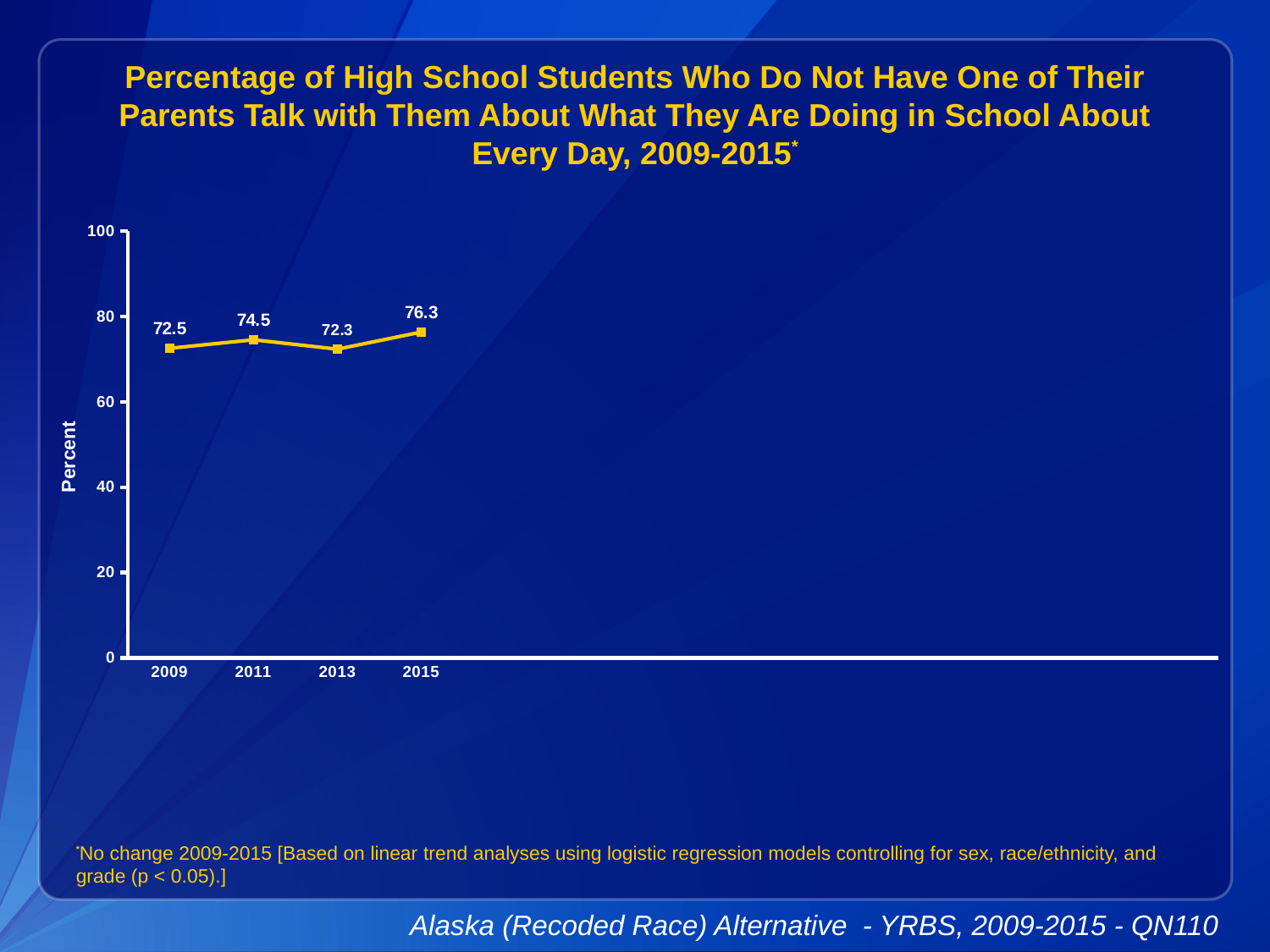
What is the label on the vertical axis? Percent What is the difference between the values for 2015 and 2009? 3.8 What is the value for 2009? 72.5 Is the value for 2015 greater or less than 80? less What is the value for 2015? 76.3 What is the value for 2011? 74.5 Which is larger, the value for 2011 or the value for 2013? 2011 Which year has the highest value? 2015 What kind of chart is shown on the slide? line chart How many years are plotted on the chart? 4 Which year has the lowest value? 2013 What is the value for 2013? 72.3